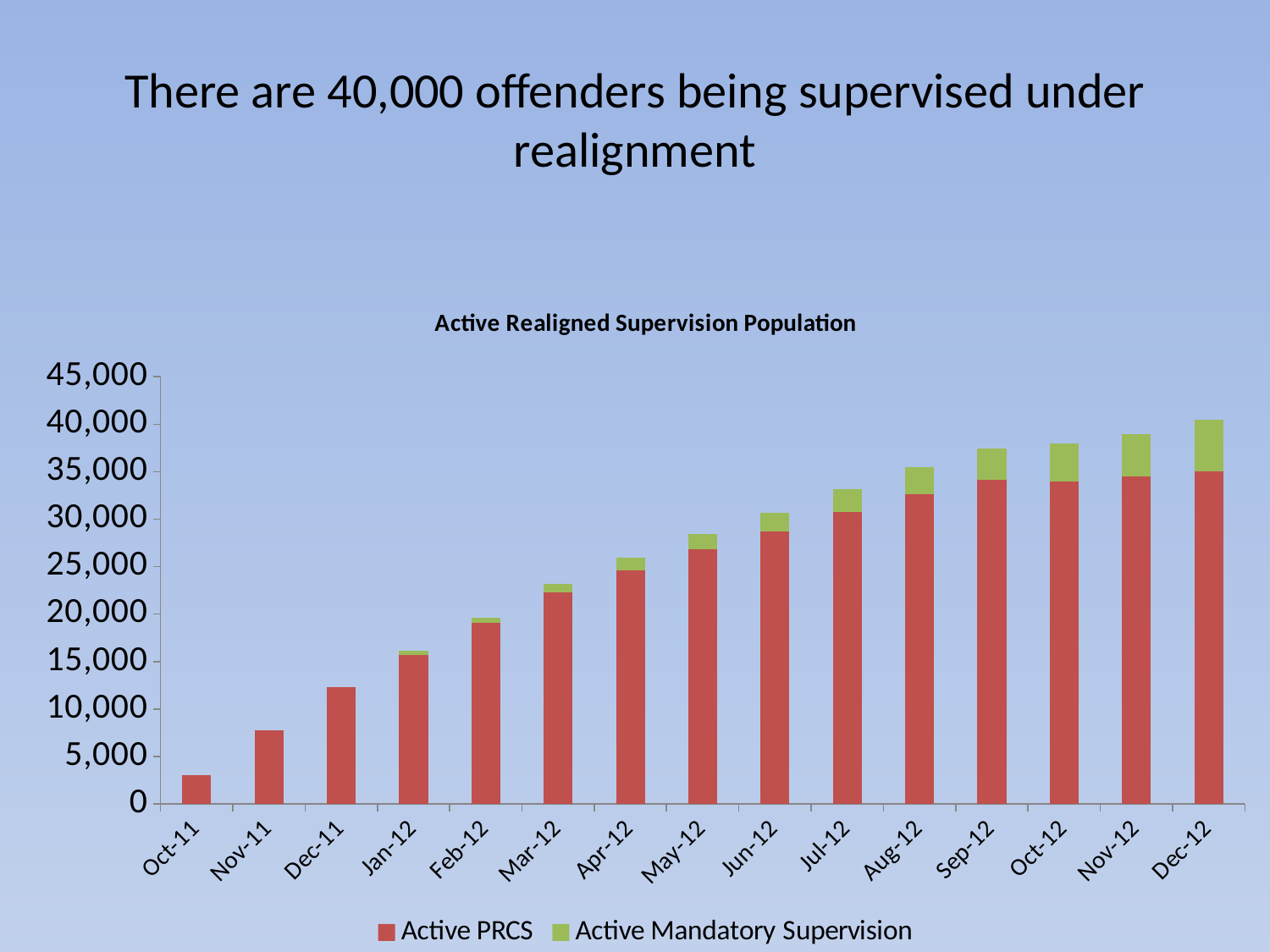
What kind of chart is shown on the slide? Stacked bar chart Is the Active PRCS value for Dec-11 greater or less than 10,000? greater How many months are shown on the x axis of the chart? 15 Does the total active realigned supervision population rise or fall from Oct-11 to Dec-12? Rise Which series is shown in green in the chart? Active Mandatory Supervision Which month has the highest total active realigned supervision population? Dec-12 How many series does the chart's legend list? 2 Is the total stacked value for Jul-12 greater or less than 30,000? greater What is the title of the chart? Active Realigned Supervision Population In Dec-12, which series is larger, Active PRCS or Active Mandatory Supervision? Active PRCS Is the Active PRCS value for Oct-11 greater or less than 5,000? less Which month has the lowest total active realigned supervision population? Oct-11